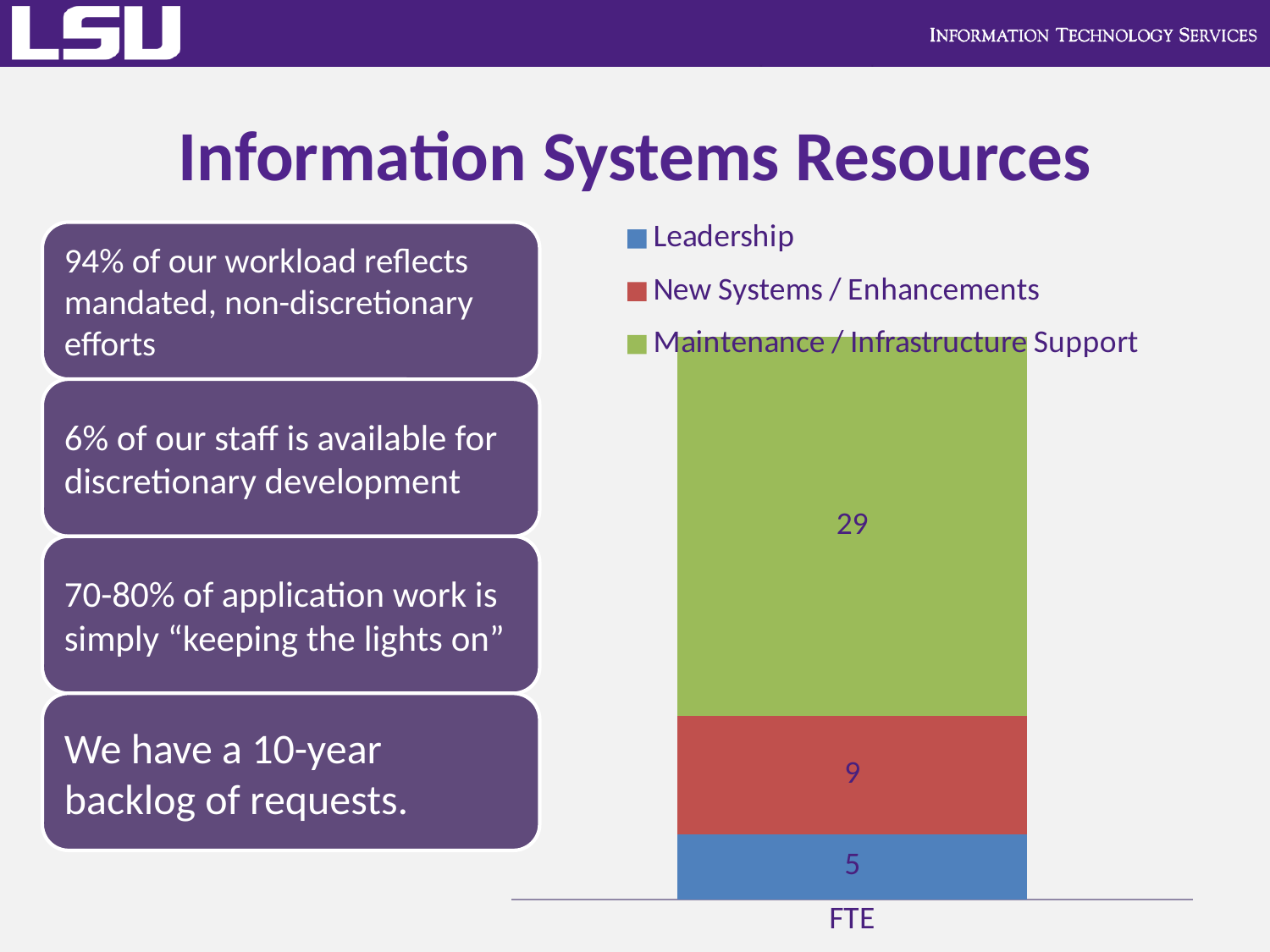
What is the value for New Systems / Enhancements in the FTE bar? 9 What is the value for Maintenance / Infrastructure Support in the FTE bar? 29 What kind of chart is shown on the slide? Stacked bar chart What is the difference between the New Systems / Enhancements value and the Leadership value? 4 What is the category label on the x axis of the chart? FTE What is the total of the stacked FTE bar? 43 How many series does the legend list? 3 Which series has the smallest value in the FTE bar? Leadership What is the difference between the Maintenance / Infrastructure Support value and the New Systems / Enhancements value? 20 Which is larger, the value for New Systems / Enhancements or the value for Leadership? New Systems / Enhancements Which series has the largest value in the FTE bar? Maintenance / Infrastructure Support What is the value for Leadership in the FTE bar? 5